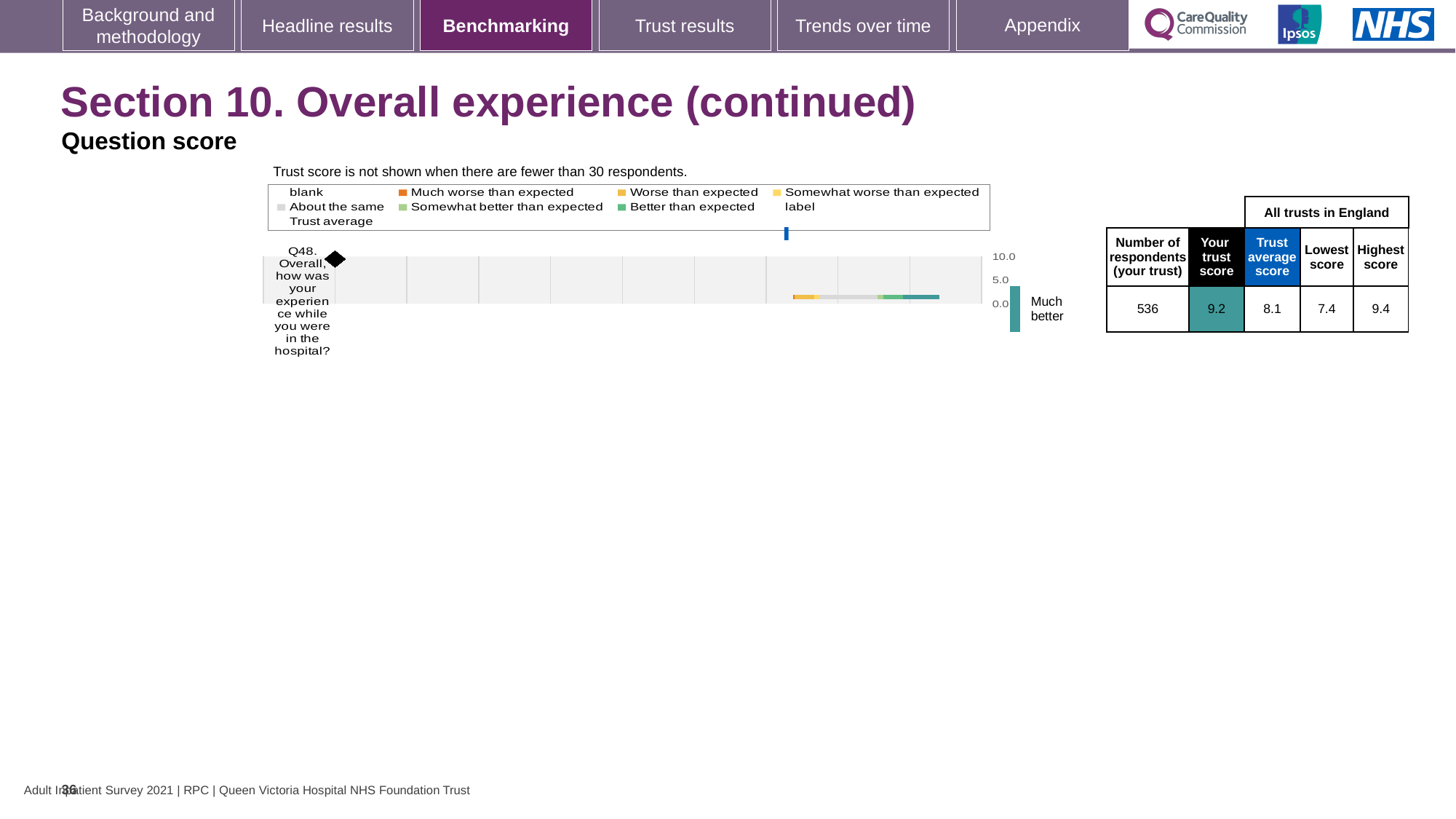
What colour does the chart legend use for 'Much worse than expected'? Orange What is the trust average score for Q48 across all trusts in England? 8.1 What is the trust score for Q48 shown on the slide? 9.2 What kind of chart is used to show the Q48 benchmarking result? Bar chart What is the difference between the trust score and the trust average score for Q48? 1.1 How many survey questions are plotted on the benchmarking chart on this slide? 1 What is the lowest score among all trusts in England for Q48? 7.4 Which is larger for Q48: the trust's own score or the trust average score? Your trust score Is the trust score for Q48 greater or less than 5.0 on the chart's axis? greater What is the highest score among all trusts in England for Q48? 9.4 How many respondents from the trust answered Q48? 536 What is the difference between the highest and lowest scores among all trusts in England for Q48? 2.0